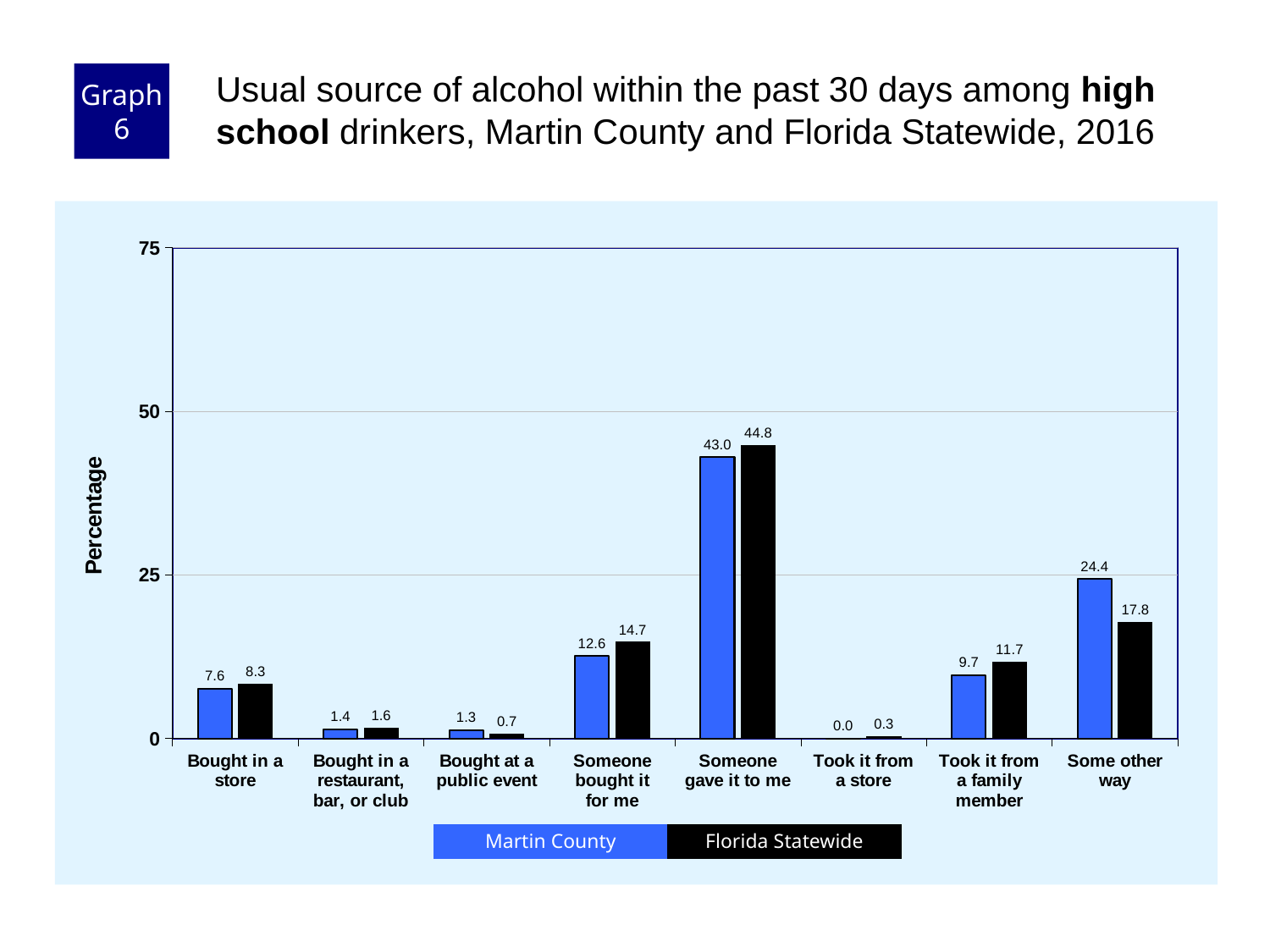
What is the Florida Statewide value for "Some other way"? 17.8 What is the difference between the Florida Statewide and Martin County values for "Some other way"? 6.6 What is the Martin County value for "Took it from a store"? 0.0 What kind of chart is shown on the slide? Bar chart How many source categories are shown on the x axis? 8 Which category has the lowest Martin County value? Took it from a store Which is larger for "Took it from a family member": Martin County or Florida Statewide? Florida Statewide How many series does the legend list? 2 Is the Martin County value for "Someone gave it to me" greater or less than 50? less What is the label on the y axis? Percentage What is the Martin County value for "Someone gave it to me"? 43.0 Which category has the highest Florida Statewide value? Someone gave it to me